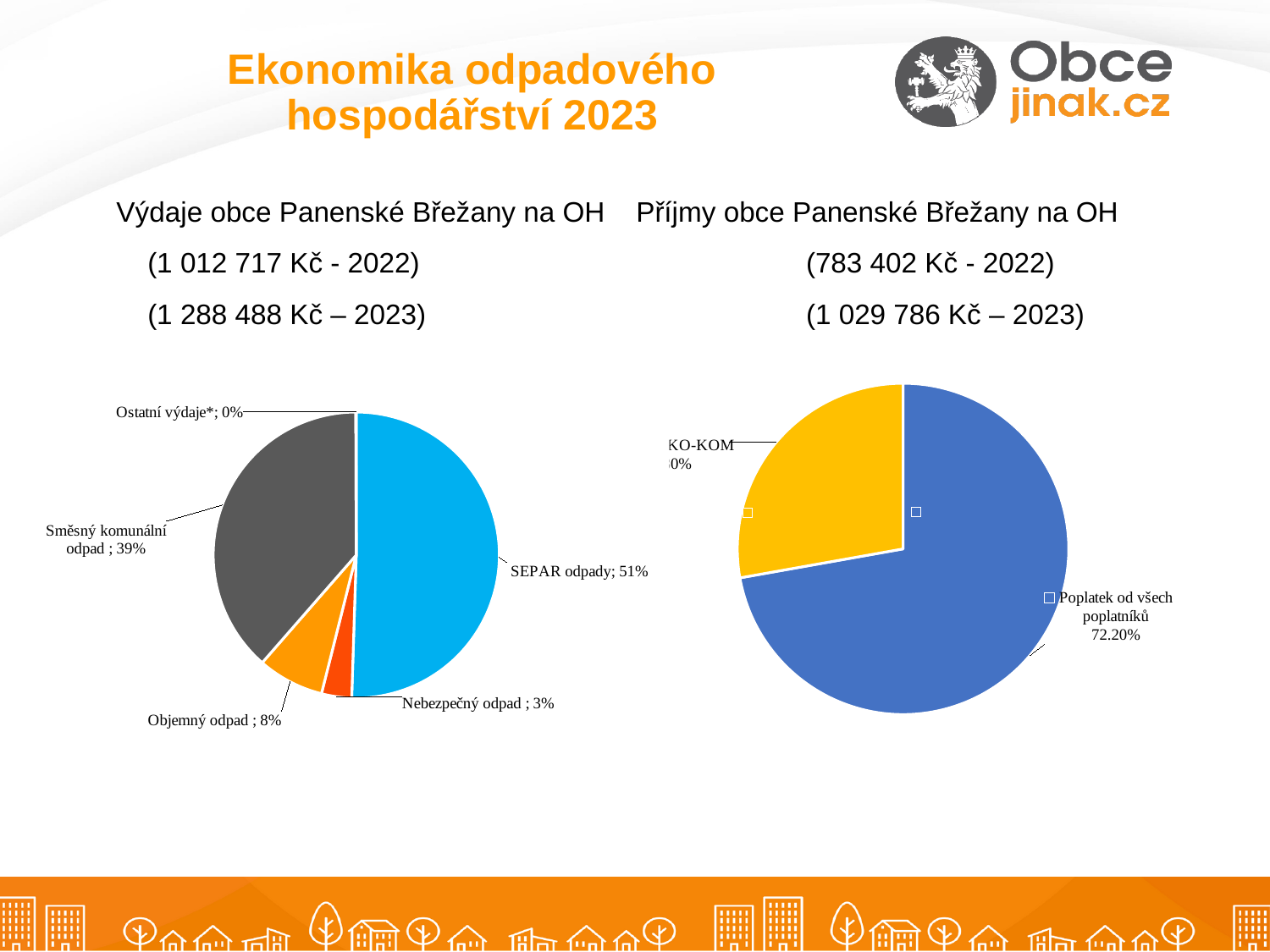
In the left pie chart (Výdaje obce Panenské Břežany na OH), what share is labelled for Nebezpečný odpad? 3% How many slices does the right pie chart (Příjmy obce Panenské Břežany na OH) have? 2 In the left pie chart (Výdaje obce Panenské Břežany na OH), which category has the largest share? SEPAR odpady In the left pie chart (Výdaje obce Panenské Břežany na OH), what share is labelled for Objemný odpad? 8% In the left pie chart (Výdaje obce Panenské Břežany na OH), which category has the smallest share? Ostatní výdaje* In the left pie chart (Výdaje obce Panenské Břežany na OH), what share is labelled for SEPAR odpady? 51% In the left pie chart (Výdaje obce Panenské Břežany na OH), which is larger: Objemný odpad or Nebezpečný odpad? Objemný odpad In the right pie chart (Příjmy obce Panenské Břežany na OH), what share is labelled for Poplatek od všech poplatníků? 72.20% In the left pie chart (Výdaje obce Panenské Břežany na OH), how many percentage points larger is SEPAR odpady than Směsný komunální odpad? 12 How many labelled categories does the left pie chart (Výdaje obce Panenské Břežany na OH) show? 5 What type of chart is used for Výdaje obce Panenské Břežany na OH? Pie chart In the left pie chart (Výdaje obce Panenské Břežany na OH), what share is labelled for Směsný komunální odpad? 39%